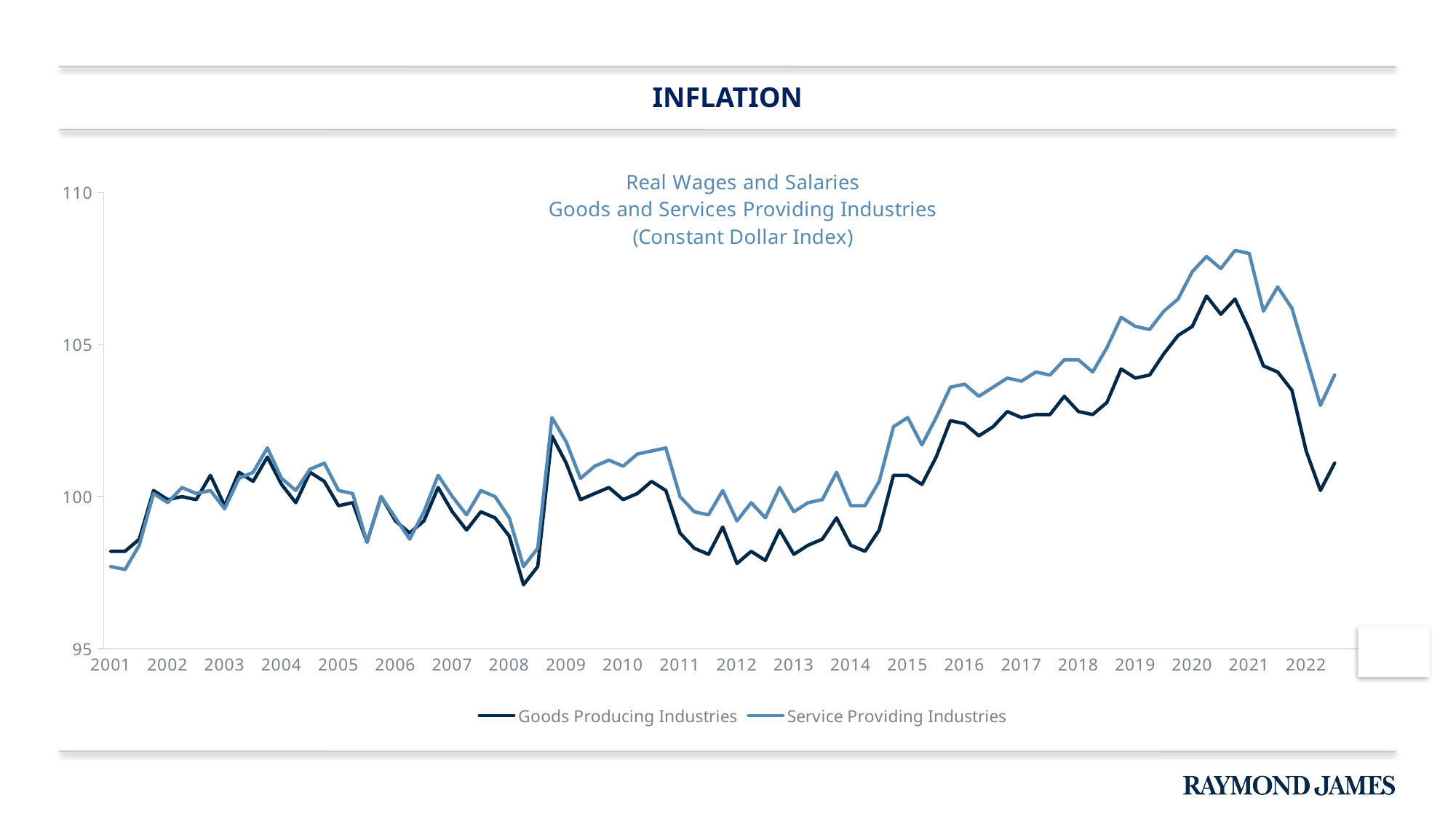
Is the value for Goods Producing Industries in 2012 greater or less than 100? less How many series does the legend list? 2 Does the Service Providing Industries line generally rise or fall between 2014 and 2020? Rise In 2020, which series is higher, Goods Producing Industries or Service Providing Industries? Service Providing Industries Is the value for Service Providing Industries in 2016 greater or less than 100? greater What kind of chart is shown on the slide? Line chart What are the two series named in the legend? Goods Producing Industries and Service Providing Industries Which series reaches the highest value on the chart? Service Providing Industries Is the lowest value for Goods Producing Industries around 2008 greater or less than 100? less What is the title of the chart? Real Wages and Salaries Goods and Services Providing Industries (Constant Dollar Index) How many year labels are shown on the x axis? 22